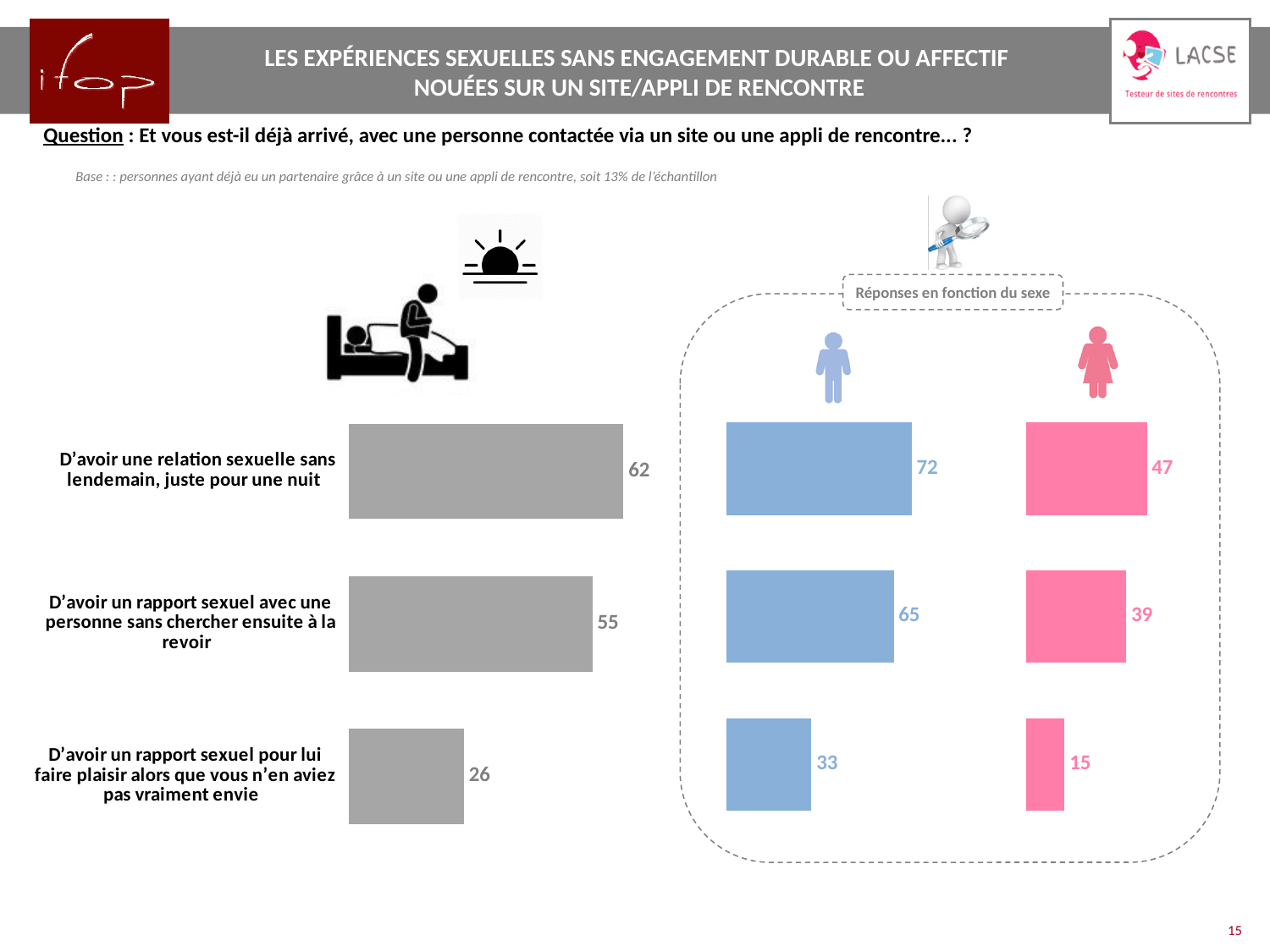
In the pink bar chart for women, what is the value for "D'avoir une relation sexuelle sans lendemain, juste pour une nuit"? 47 In the blue bar chart for men (left side of the "Réponses en fonction du sexe" box), what is the value for "D'avoir un rapport sexuel avec une personne sans chercher ensuite à la revoir"? 65 In the grey overall bar chart, what is the value for "D'avoir une relation sexuelle sans lendemain, juste pour une nuit"? 62 For "D'avoir un rapport sexuel pour lui faire plaisir alors que vous n'en aviez pas vraiment envie", which is larger: the men's value (blue) or the women's value (pink)? Men's value (33) What colour are the bars representing women's responses in the "Réponses en fonction du sexe" box? Pink In the blue bar chart for men, which item has the highest value? D'avoir une relation sexuelle sans lendemain, juste pour une nuit In the grey overall bar chart, what is the value for "D'avoir un rapport sexuel pour lui faire plaisir alors que vous n'en aviez pas vraiment envie"? 26 What type of chart is used to display the overall results on the left of the slide? Bar chart In the pink bar chart for women, which item has the lowest value? D'avoir un rapport sexuel pour lui faire plaisir alors que vous n'en aviez pas vraiment envie How many items (categories) are shown in the grey overall bar chart? 3 What is the difference between the men's value (blue) and the women's value (pink) for "D'avoir une relation sexuelle sans lendemain, juste pour une nuit"? 25 In the grey overall bar chart, what is the difference between the values for "D'avoir une relation sexuelle sans lendemain" and "D'avoir un rapport sexuel avec une personne sans chercher ensuite à la revoir"? 7